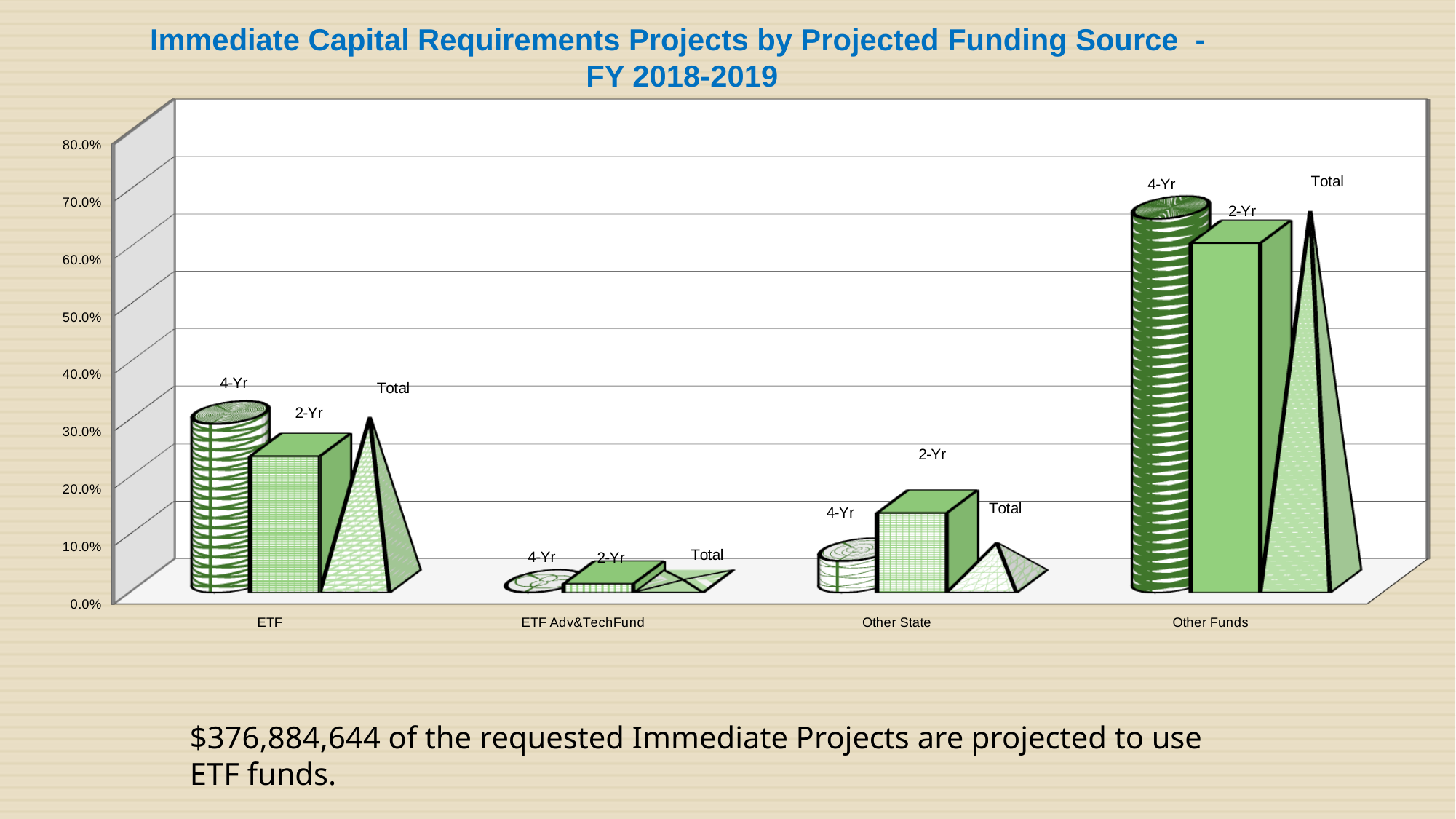
Is the 2-Yr value for Other State greater or less than 30.0%? less Which is larger, the 2-Yr value for Other Funds or the 2-Yr value for ETF? Other Funds What is the title of the chart? Immediate Capital Requirements Projects by Projected Funding Source - FY 2018-2019 Is the 4-Yr value for Other Funds greater or less than 50.0%? greater How many funding source categories are shown on the x axis? 4 What kind of chart is shown on the slide? Bar chart Which funding source has the highest 4-Yr value? Other Funds Is the 2-Yr value for ETF Adv&TechFund greater or less than 10.0%? less What are the three series labels shown above the bars in each category? 4-Yr, 2-Yr, Total Which funding source has the lowest 4-Yr value? ETF Adv&TechFund Which is larger, the 4-Yr value for ETF or the 4-Yr value for Other State? ETF